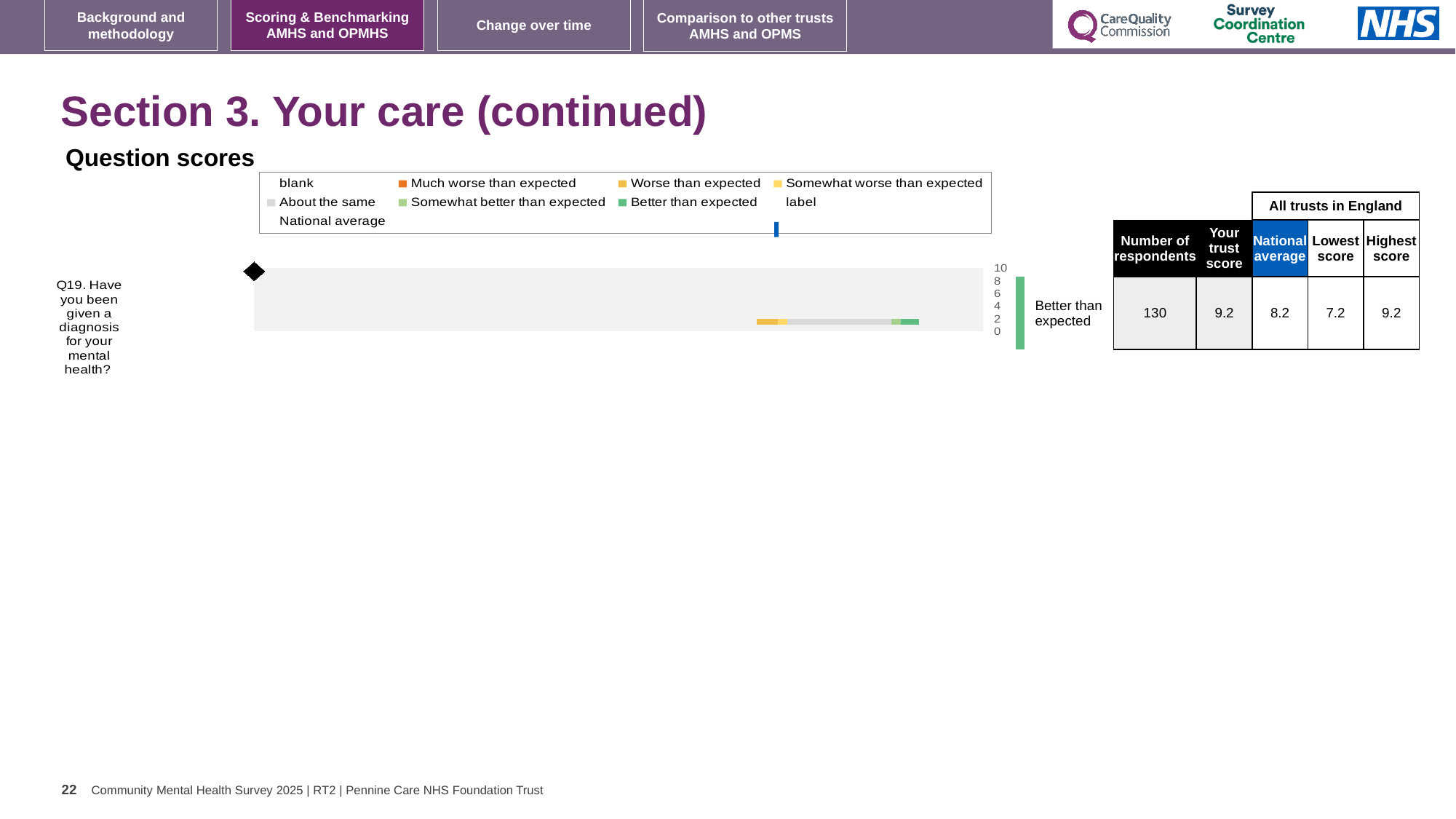
Which is larger for Q19, the trust's score or the national average? the trust's score What is the national average score for Q19 according to the table? 8.2 What is the difference between the trust's score and the national average for Q19? 1.0 How many questions are plotted in the question scores chart? 1 What is the highest score among all trusts in England for Q19? 9.2 What kind of chart is used to show the question scores on this slide? bar chart What is the highest value shown on the chart's axis? 10 What is the trust's score for Q19 according to the table? 9.2 What benchmark category is the trust's Q19 score placed in, as labelled beside the chart? Better than expected Which question is shown in the question scores chart? Q19. Have you been given a diagnosis for your mental health? What is the lowest score among all trusts in England for Q19? 7.2 How many respondents answered Q19? 130